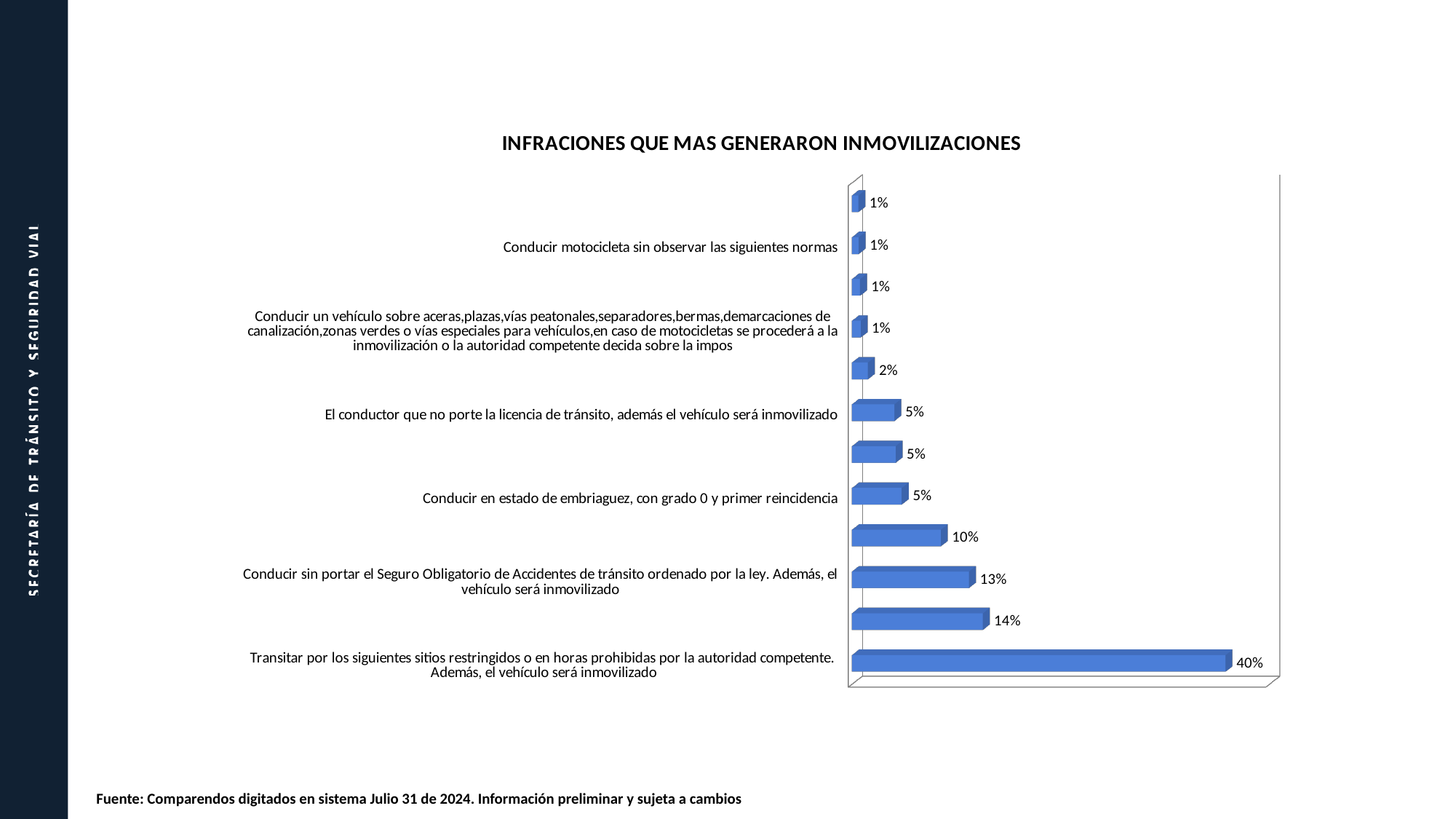
What is the difference between the value for 'Transitar por los siguientes sitios restringidos...' (40%) and 'Conducir sin portar el Seguro Obligatorio...' (13%)? 27% How many bars are plotted in the chart? 12 What is the value for 'Conducir sin portar el Seguro Obligatorio de Accidentes de tránsito ordenado por la ley. Además, el vehículo será inmovilizado'? 13% What type of chart is shown on the slide? Bar chart How many bars in the chart have a value of 1%? 4 Which category has the highest value in the chart? Transitar por los siguientes sitios restringidos o en horas prohibidas por la autoridad competente. Además, el vehículo será inmovilizado What is the value for 'Conducir en estado de embriaguez, con grado 0 y primer reincidencia'? 5% Which has a larger value: 'Conducir sin portar el Seguro Obligatorio de Accidentes de tránsito...' or 'El conductor que no porte la licencia de tránsito...'? Conducir sin portar el Seguro Obligatorio de Accidentes de tránsito ordenado por la ley. Además, el vehículo será inmovilizado What is the value for 'Conducir motocicleta sin observar las siguientes normas'? 1% What is the title of the chart? INFRACIONES QUE MAS GENERARON INMOVILIZACIONES What is the value for 'El conductor que no porte la licencia de tránsito, además el vehículo será inmovilizado'? 5% What is the value for 'Transitar por los siguientes sitios restringidos o en horas prohibidas por la autoridad competente. Además, el vehículo será inmovilizado'? 40%